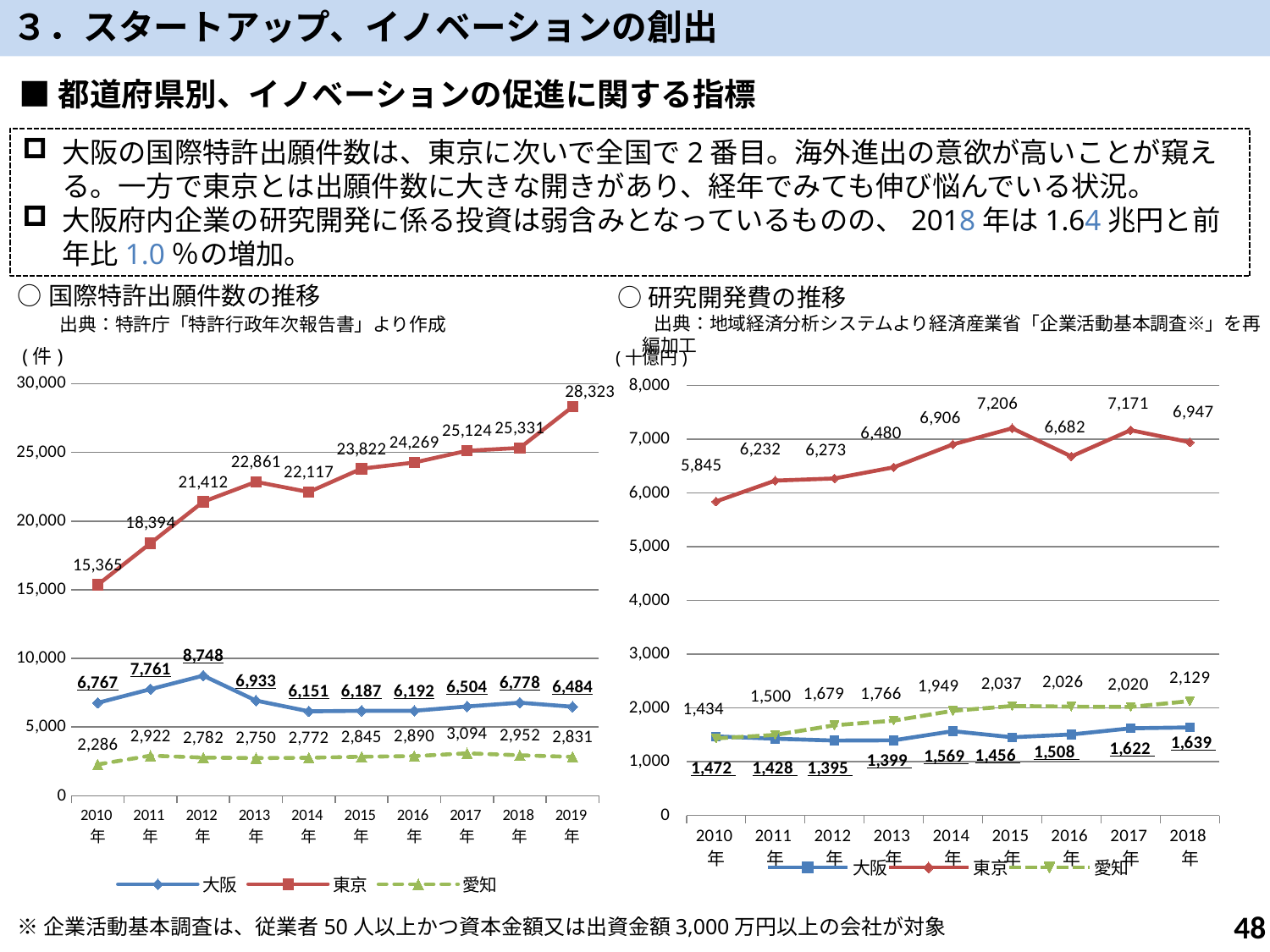
In the 国際特許出願件数の推移 chart, what is the value for 東京 in 2019年? 28,323 In the 研究開発費の推移 chart, in which year is the 大阪 series lowest? 2012年 In the 研究開発費の推移 chart, which is larger in 2018年, 愛知 or 大阪? 愛知 In the 国際特許出願件数の推移 chart, what is the difference between 東京 and 大阪 in 2019年? 21,839 In the 研究開発費の推移 chart, what is the value for 東京 in 2015年? 7,206 In the 国際特許出願件数の推移 chart, does the 東京 series generally rise or fall from 2010年 to 2019年? rise In the 国際特許出願件数の推移 chart, what is the value for 大阪 in 2012年? 8,748 In the 国際特許出願件数の推移 chart, in which year is the 大阪 series highest? 2012年 In the 国際特許出願件数の推移 chart, how many series does the legend list? 3 What type of chart is the 研究開発費の推移 chart? line chart In the 国際特許出願件数の推移 chart, how many years are shown on the x axis? 10 In the 研究開発費の推移 chart, what is the value for 大阪 in 2018年? 1,639